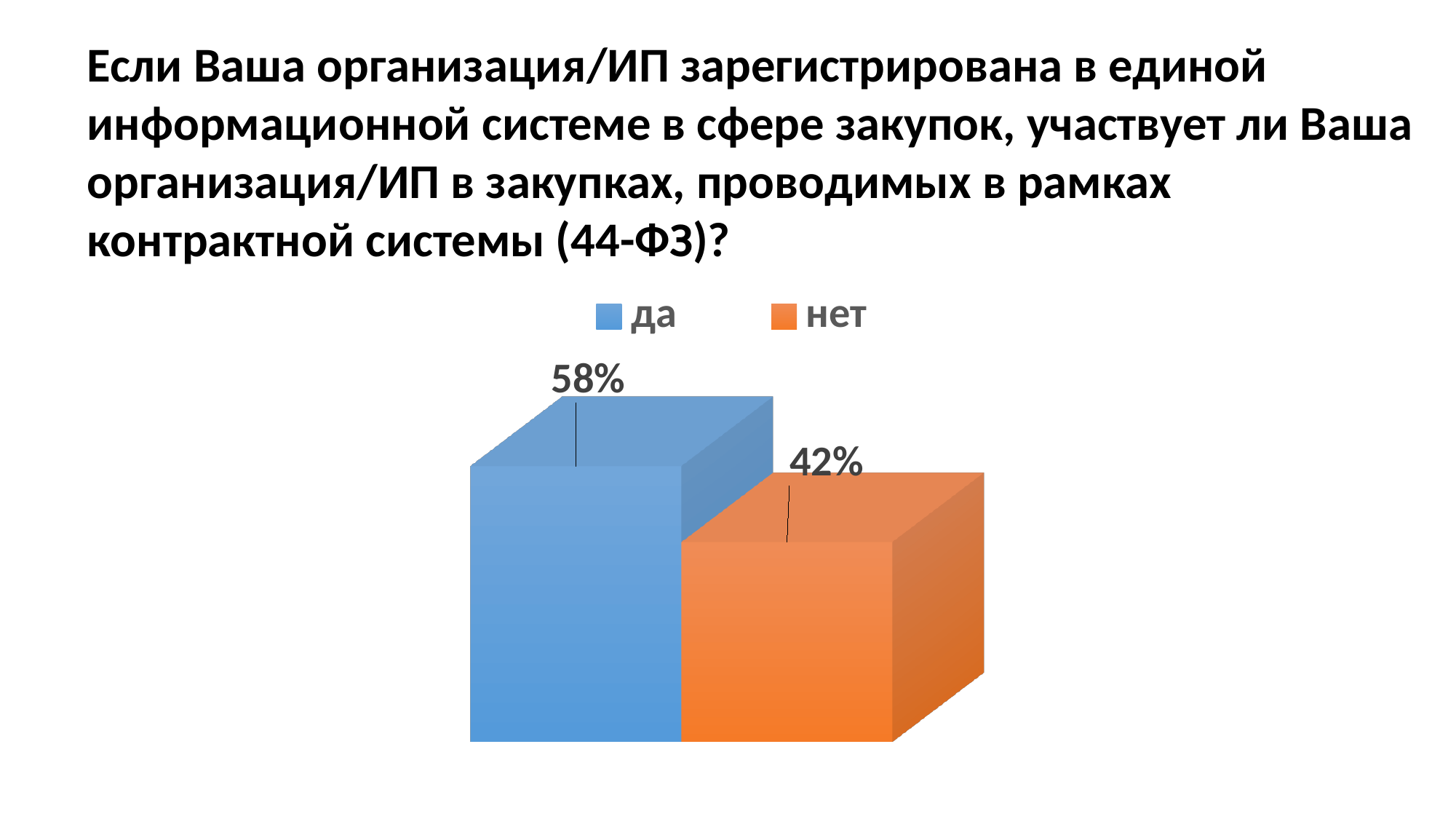
What is the total of the two values shown in the chart? 100% What colour is the bar for "нет"? orange What is the value for "да"? 58% What is the difference between the values for "да" and "нет"? 16% What kind of chart is shown on the slide? bar chart Which category has the lowest value? нет How many series does the legend list? 2 What colour is the bar for "да"? blue How many categories are shown in the chart? 2 Which category has the highest value? да Which is larger, the value for "да" or the value for "нет"? да What is the value for "нет"? 42%